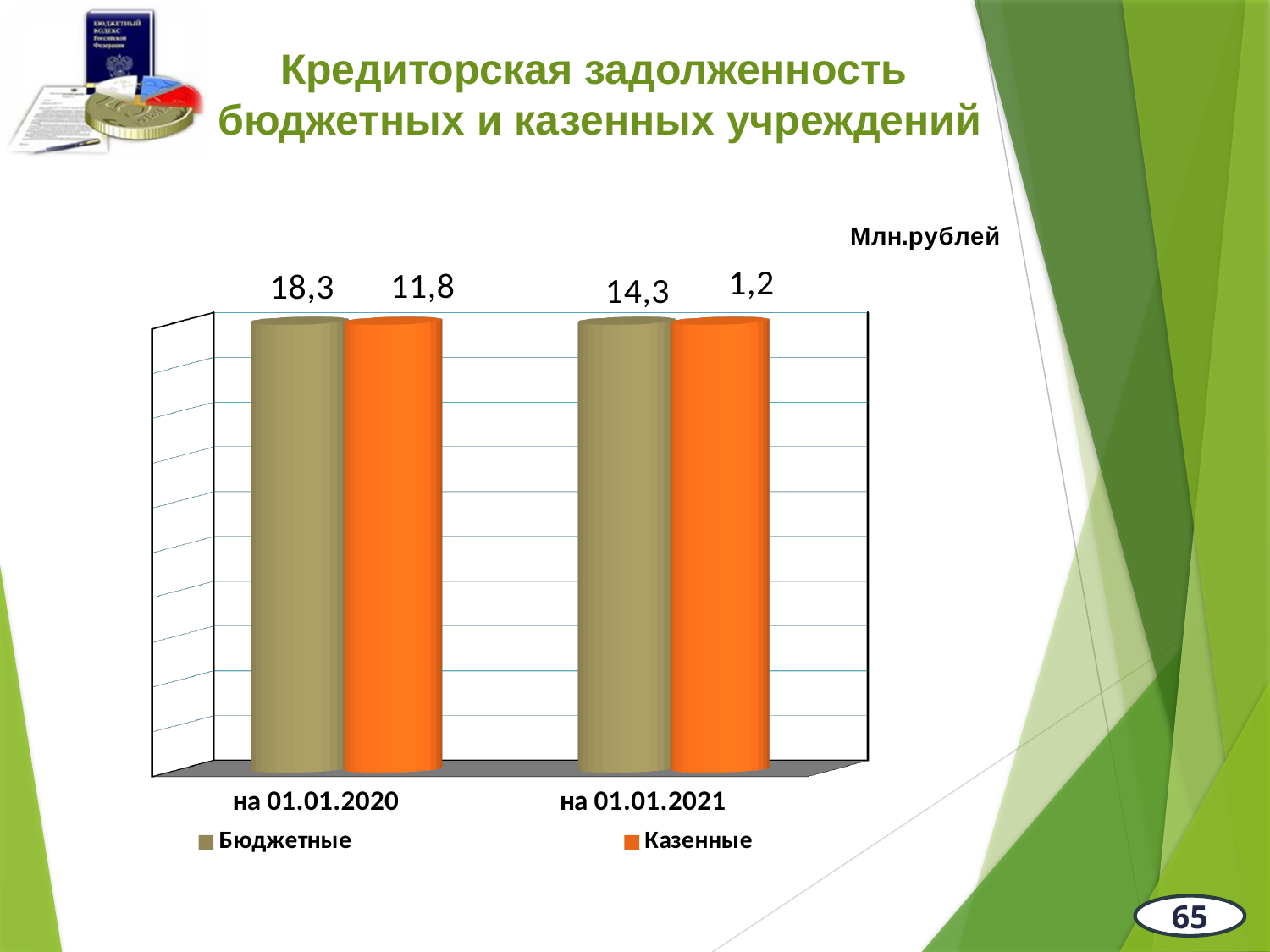
What is the difference between the Казенные values on 01.01.2020 and 01.01.2021? 10,6 What is the value for Бюджетные on 01.01.2020? 18,3 Does the Бюджетные value rise or fall from 01.01.2020 to 01.01.2021? fall What unit is stated for the chart values? Млн.рублей What is the difference between the Бюджетные values on 01.01.2020 and 01.01.2021? 4,0 Which date has the highest Казенные value? на 01.01.2020 What is the value for Казенные on 01.01.2021? 1,2 How many categories are shown on the x axis? 2 How many series does the legend list? 2 Which series has the larger value on 01.01.2021, Бюджетные or Казенные? Бюджетные What is the value for Бюджетные on 01.01.2021? 14,3 What is the value for Казенные on 01.01.2020? 11,8